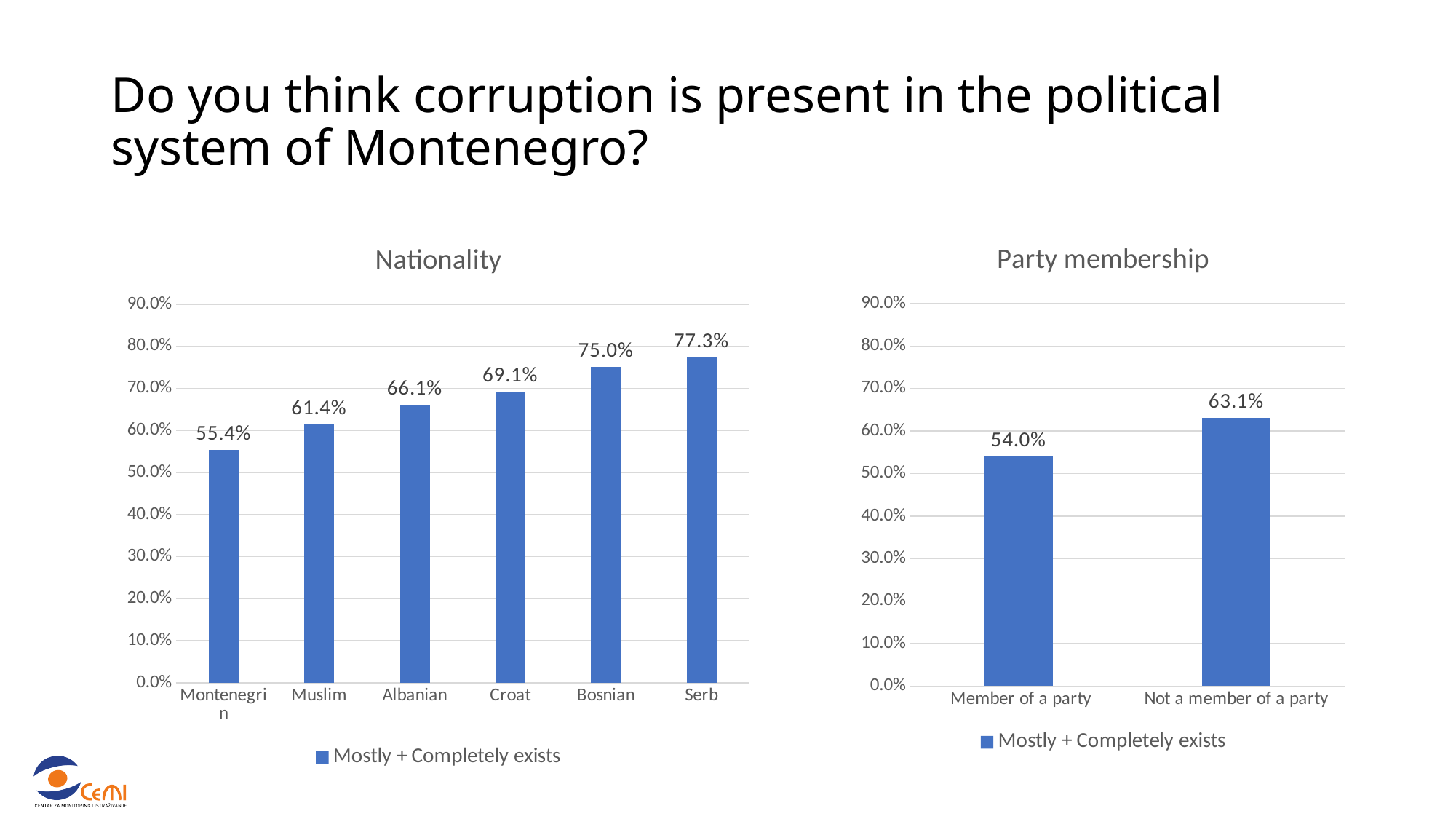
In the Nationality chart, what is the value for Montenegrin? 55.4% In the Nationality chart, which is larger, the value for Muslim or the value for Albanian? Albanian In the Party membership chart, what is the difference between Not a member of a party and Member of a party? 9.1% In the Nationality chart, do the values rise or fall from left to right along the x axis? rise In the Nationality chart, which nationality has the lowest value? Montenegrin How many series does the legend of the Nationality chart list? 1 In the Nationality chart, which nationality has the highest value? Serb What kind of chart is the Party membership chart? bar chart In the Party membership chart, what is the value for Member of a party? 54.0% In the Nationality chart, how many nationality categories are shown? 6 In the Nationality chart, what is the value for Croat? 69.1% In the Nationality chart, what is the difference between the values for Serb and Montenegrin? 21.9%